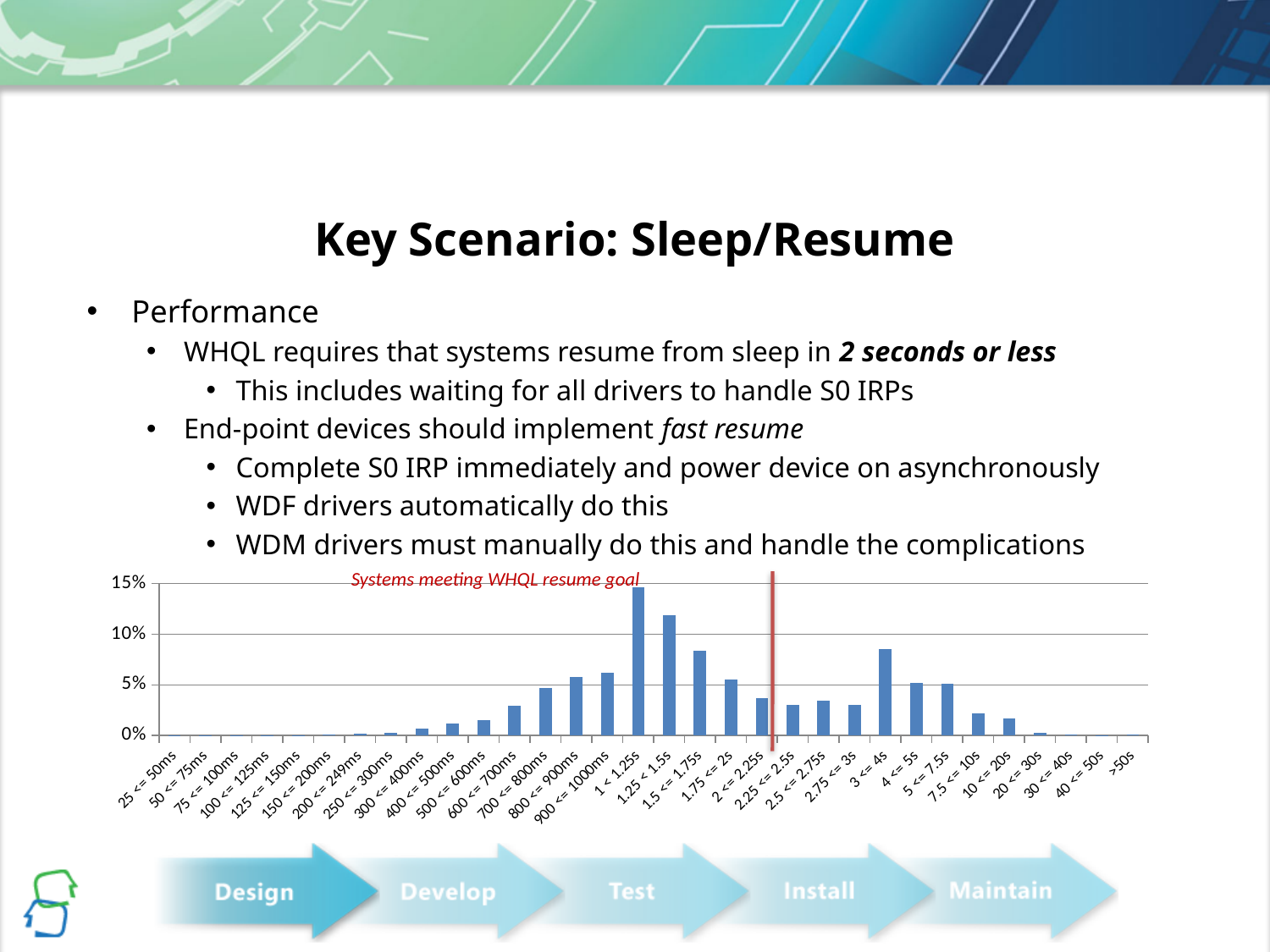
What kind of chart is shown on the slide? bar chart Is the value for 2 <= 2.25s greater or less than 5%? less Which category has the highest bar in the chart? 1 < 1.25s Is the value for 3 <= 4s greater or less than 5%? greater Is the value for 1.25 < 1.5s greater or less than 10%? greater Do the bar values generally rise or fall from 25 <= 50ms to 1 < 1.25s? rise Which is larger, the value for 1.5 <= 1.75s or the value for 2 <= 2.25s? 1.5 <= 1.75s Which is larger, the value for 1 < 1.25s or the value for 3 <= 4s? 1 < 1.25s What does the red text annotation on the chart say? Systems meeting WHQL resume goal